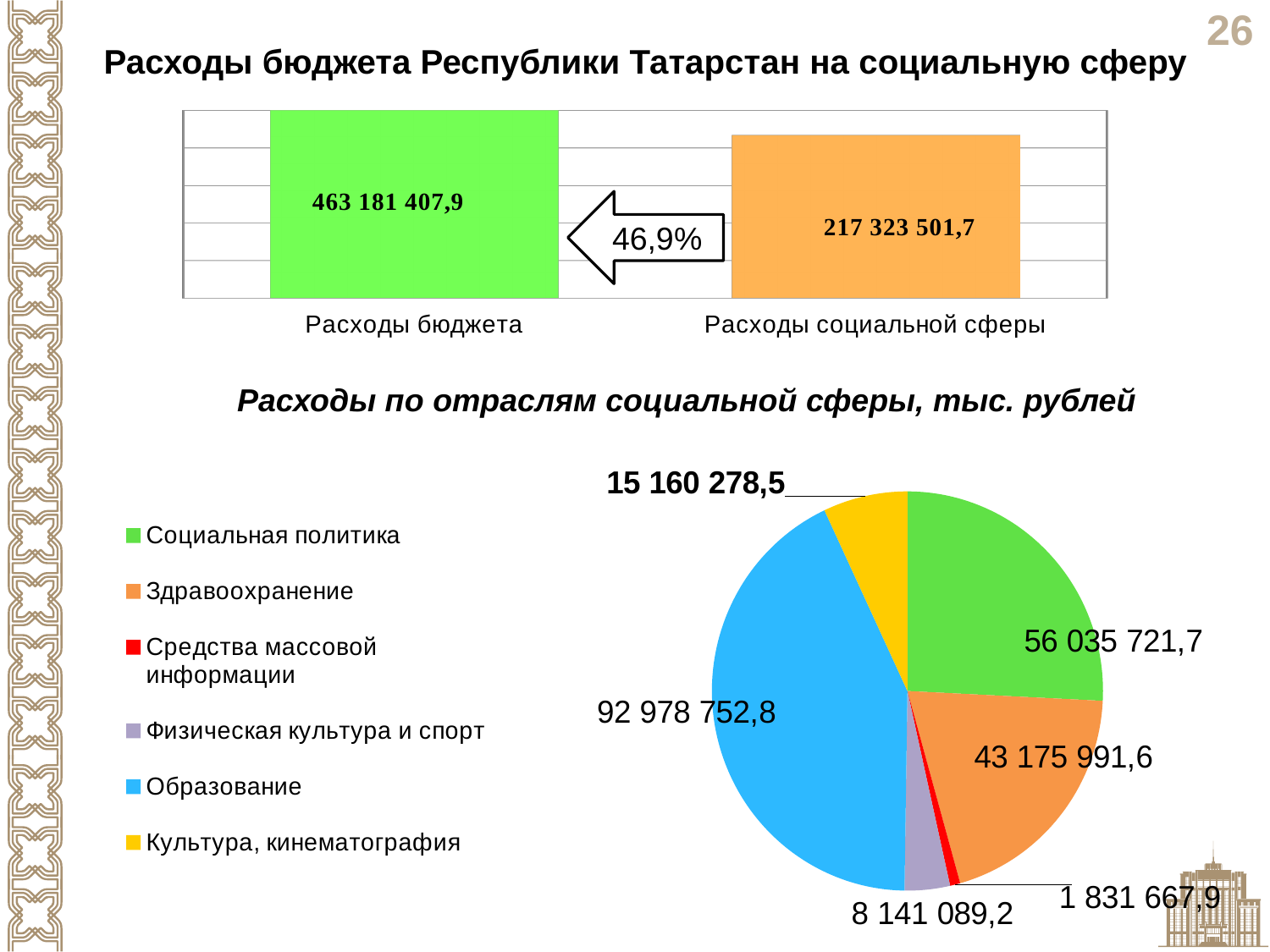
On the pie chart Расходы по отраслям социальной сферы, what is the value for Здравоохранение? 43 175 991,6 On the pie chart Расходы по отраслям социальной сферы, which category has the smallest slice? Средства массовой информации On the pie chart Расходы по отраслям социальной сферы, which is larger: Физическая культура и спорт or Культура, кинематография? Культура, кинематография On the top bar chart, what percentage is shown in the arrow between the two bars? 46,9% On the top bar chart, what is the difference between Расходы бюджета and Расходы социальной сферы? 245 857 906,2 What kind of chart is the top chart on the slide? Bar chart On the pie chart Расходы по отраслям социальной сферы, what is the difference between Образование and Социальная политика? 36 943 031,1 On the top bar chart, what is the value for Расходы бюджета? 463 181 407,9 On the pie chart Расходы по отраслям социальной сферы, how many categories does the legend list? 6 On the pie chart Расходы по отраслям социальной сферы, what is the value for Образование? 92 978 752,8 On the pie chart Расходы по отраслям социальной сферы, which category has the largest slice? Образование On the top bar chart, what is the value for Расходы социальной сферы? 217 323 501,7